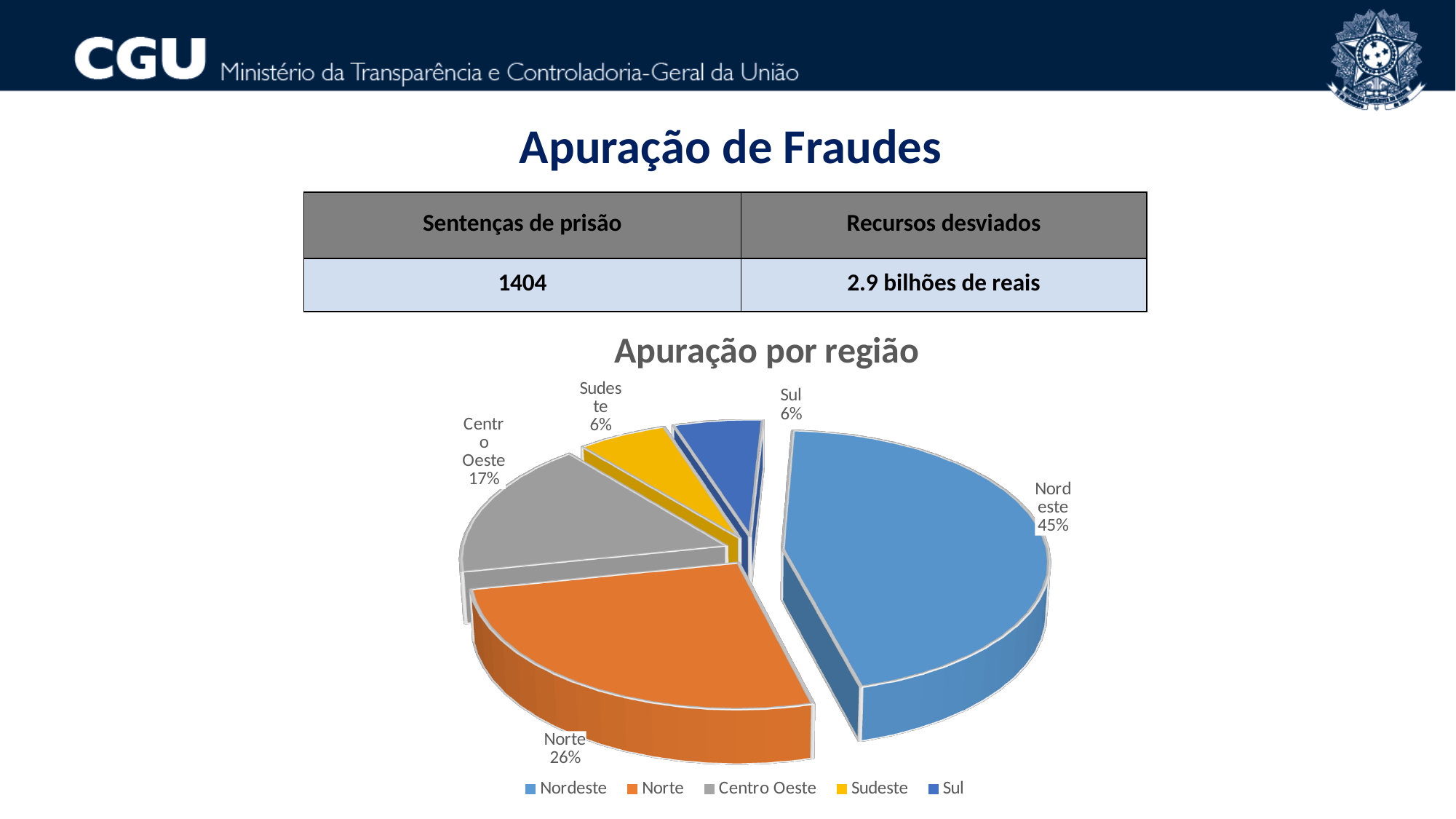
How many regions are shown in the pie chart? 5 What is the difference in percentage points between Norte and Centro Oeste? 9 What is the difference in percentage points between Nordeste and Norte? 19 What kind of chart is shown on the slide? Pie chart What share of the pie does Centro Oeste have? 17% What is the title of the chart? Apuração por região What share of the pie does Nordeste have? 45% Which region has the largest slice of the pie? Nordeste What share of the pie does Sudeste have? 6% Which is larger, the share for Centro Oeste or the share for Sudeste? Centro Oeste Which colour represents Norte in the pie chart? Orange